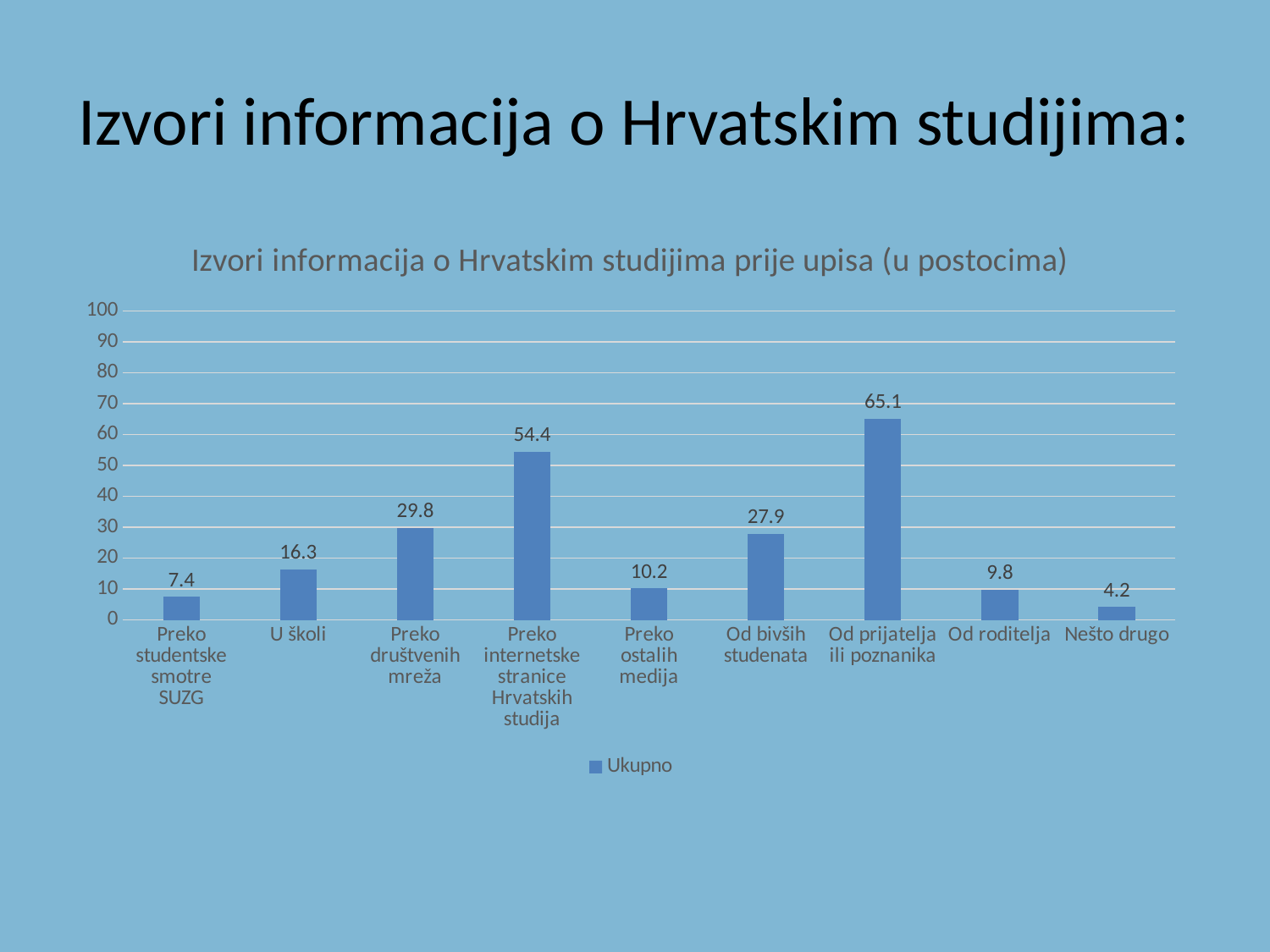
Is the value for "Preko ostalih medija" greater or less than 20? less What is the value for "Preko internetske stranice Hrvatskih studija"? 54.4 What is the difference between the values for "Od prijatelja ili poznanika" and "Preko internetske stranice Hrvatskih studija"? 10.7 Which is larger, the value for "Preko društvenih mreža" or the value for "Od bivših studenata"? Preko društvenih mreža How many categories are shown on the x axis? 9 What is the value for "Od prijatelja ili poznanika"? 65.1 What kind of chart is shown on the slide? bar chart Which category has the highest value? Od prijatelja ili poznanika What is the name of the series shown in the legend? Ukupno What is the value for "U školi"? 16.3 How many series does the legend list? 1 Which category has the lowest value? Nešto drugo